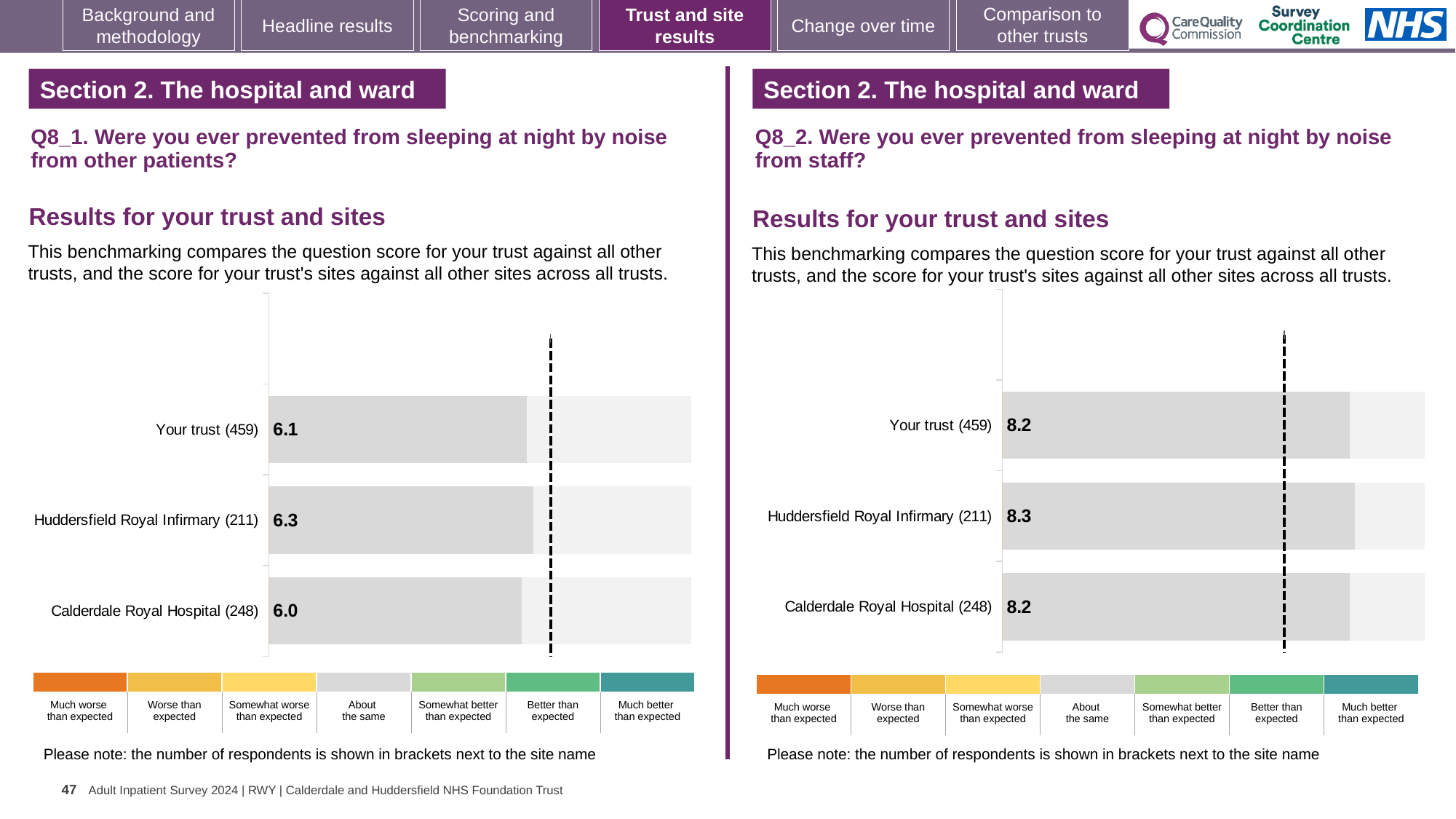
On the Q8_1 chart (noise from other patients), which site or trust has the highest score? Huddersfield Royal Infirmary On the Q8_1 chart (noise from other patients), what is the difference between the Huddersfield Royal Infirmary score and the Calderdale Royal Hospital score? 0.3 On the Q8_2 chart (noise from staff), which site or trust has the highest score? Huddersfield Royal Infirmary On the Q8_1 chart (noise from other patients), which site or trust has the lowest score? Calderdale Royal Hospital On the Q8_1 chart (noise from other patients), what is the score for Huddersfield Royal Infirmary? 6.3 On the Q8_1 chart (noise from other patients), what is the score for Your trust? 6.1 On the Q8_2 chart (noise from staff), what is the score for Huddersfield Royal Infirmary? 8.3 On the Q8_2 chart (noise from staff), what is the score for Your trust? 8.2 What kind of chart is used on the Q8_2 chart (noise from staff)? Bar chart On the Q8_1 chart (noise from other patients), what is the score for Calderdale Royal Hospital? 6.0 On the Q8_2 chart (noise from staff), what is the score for Calderdale Royal Hospital? 8.2 How many bars are plotted on the Q8_1 chart (noise from other patients)? 3